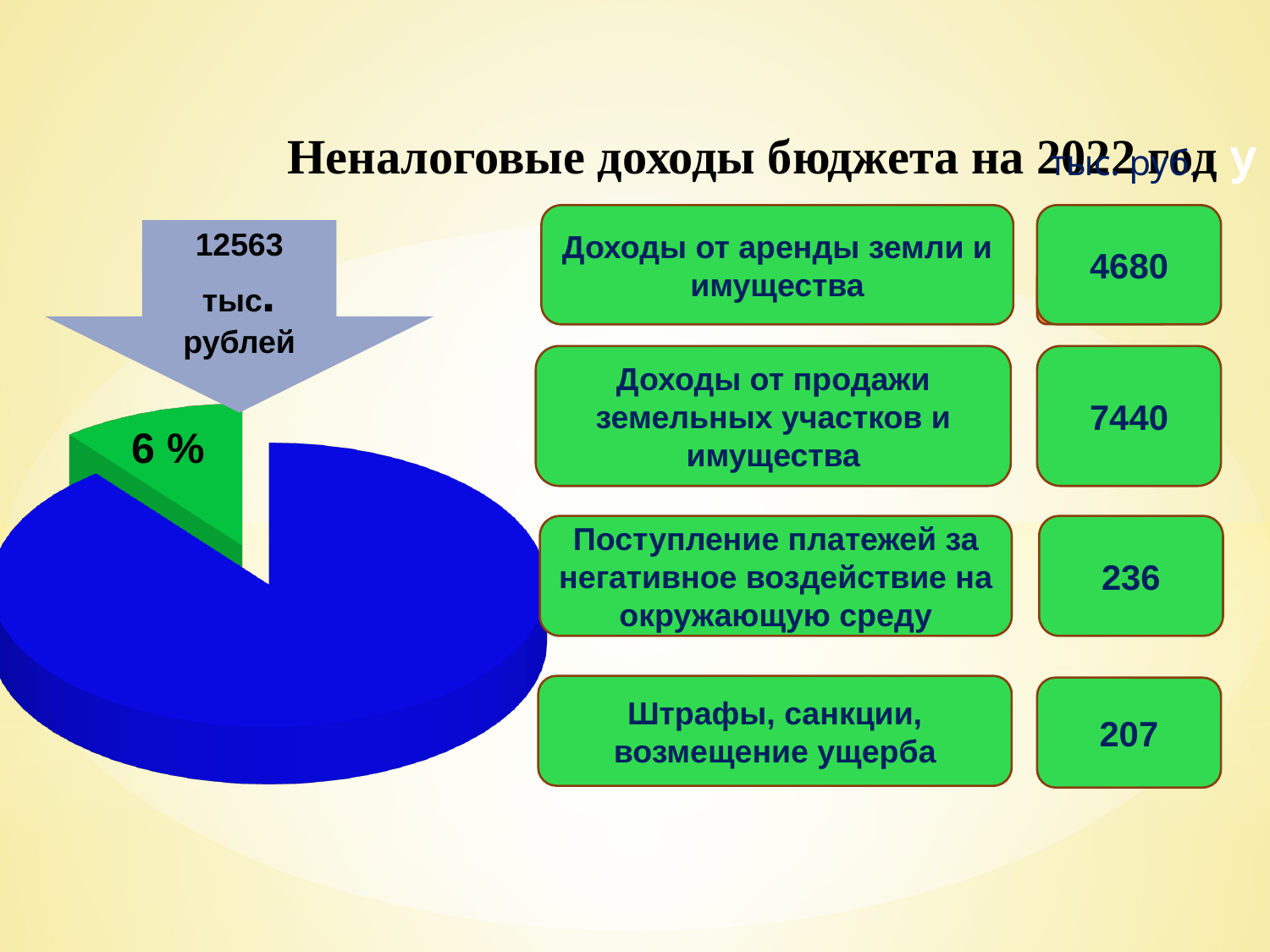
What is the title of the slide with the pie chart? Неналоговые доходы бюджета на 2022 год What value is shown for "Доходы от аренды земли и имущества"? 4680 What colour is the slice labelled 6 %? green Which slice of the pie is larger, the blue one or the green one? blue What value is shown for "Штрафы, санкции, возмещение ущерба"? 207 Which of the four listed non-tax revenue items has the highest value? Доходы от продажи земельных участков и имущества What share of the pie does the green slice represent? 6 % What value is shown for "Доходы от продажи земельных участков и имущества"? 7440 What amount is written in the arrow pointing to the 6 % slice? 12563 тыс. рублей What kind of chart is shown on the slide? pie chart What is the difference between the values for "Доходы от продажи земельных участков и имущества" and "Доходы от аренды земли и имущества"? 2760 How many slices does the pie chart have? 2